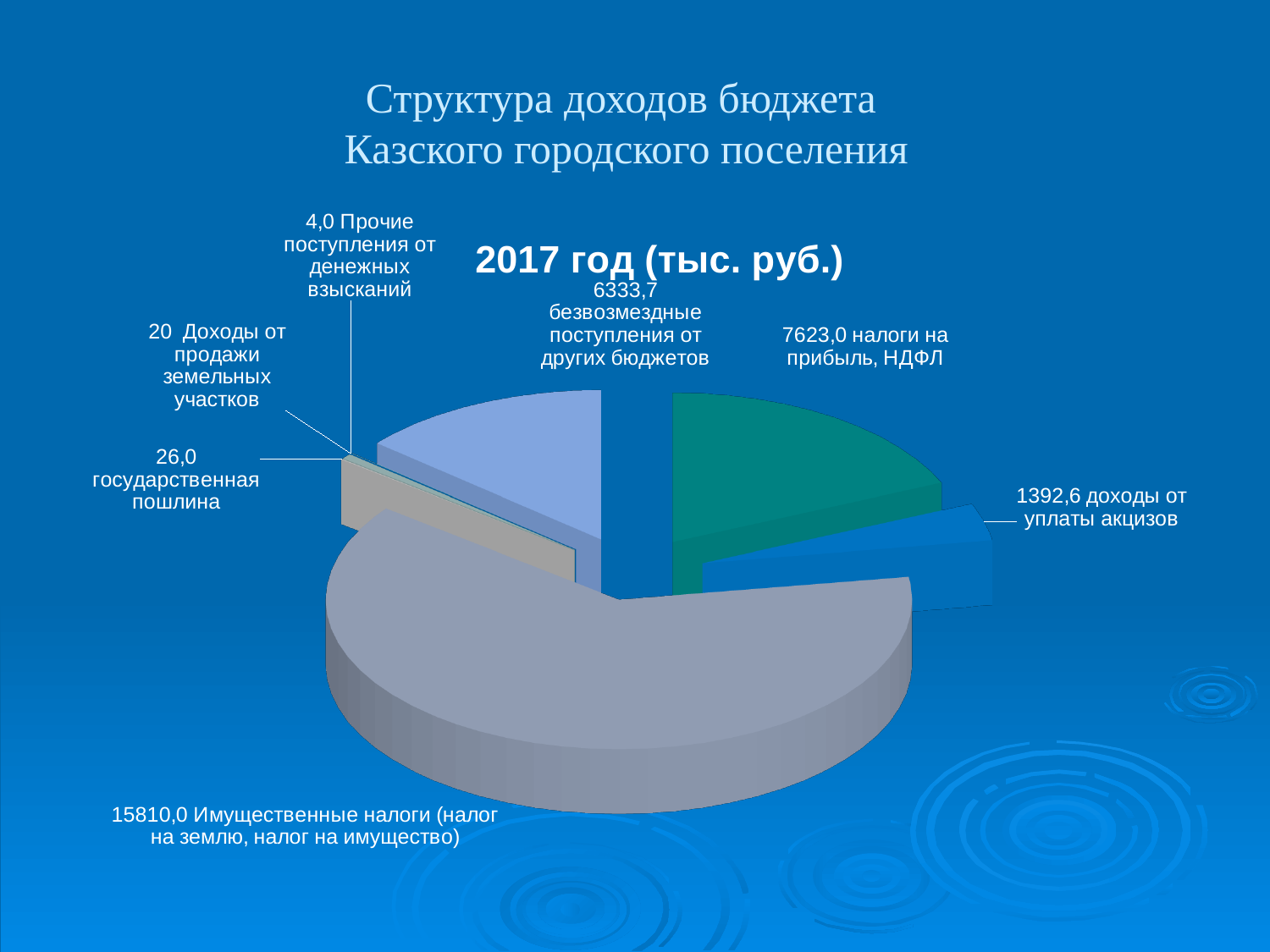
What is the value for налоги на прибыль, НДФЛ? 7623,0 What is the value for Имущественные налоги (налог на землю, налог на имущество)? 15810,0 Which category has the largest value? Имущественные налоги (налог на землю, налог на имущество) Which is larger: налоги на прибыль, НДФЛ or безвозмездные поступления от других бюджетов? налоги на прибыль, НДФЛ What is the value for доходы от уплаты акцизов? 1392,6 What is the value for безвозмездные поступления от других бюджетов? 6333,7 What is the value for государственная пошлина? 26,0 What is the difference between налоги на прибыль, НДФЛ and безвозмездные поступления от других бюджетов? 1289,3 What type of chart is shown on the slide? Pie chart Which category has the smallest value? Прочие поступления от денежных взысканий What is the title of the chart? 2017 год (тыс. руб.)